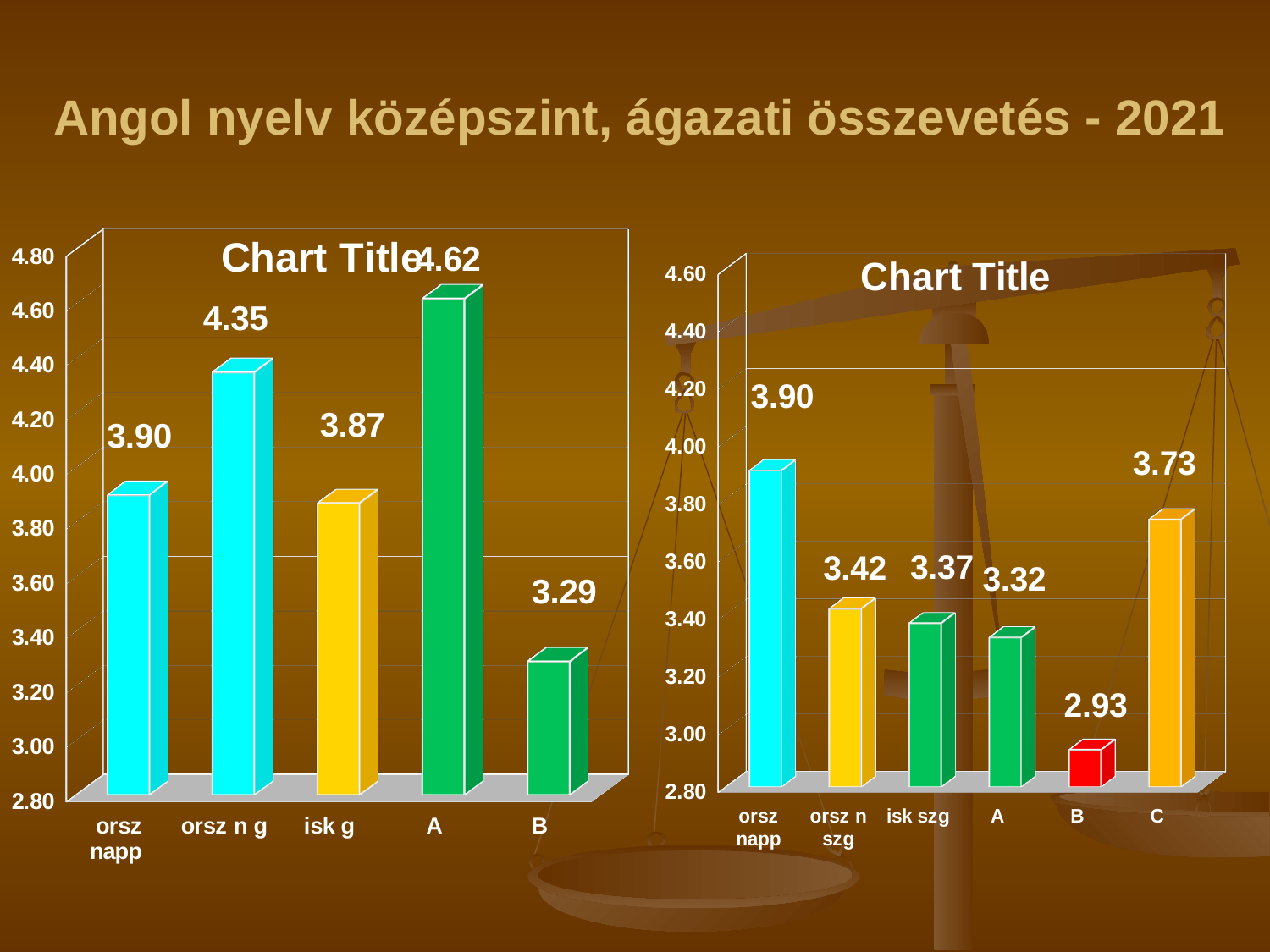
In the left chart, which category has the highest value? A In the left chart, how many categories are shown on the x axis? 5 In the right chart, which category has the lowest value? B In the right chart, how many categories are shown on the x axis? 6 In the left chart, what is the difference between the values for A and B? 1.33 In the right chart, what is the difference between the values for orsz napp and B? 0.97 In the right chart, which category has the highest value? orsz napp In the right chart, which is larger, the value for orsz n szg or the value for isk szg? orsz n szg In the left chart, which category has the lowest value? B In the left chart, what is the value for orsz n g? 4.35 In the right chart, what is the value for C? 3.73 What kind of chart is the left chart? bar chart